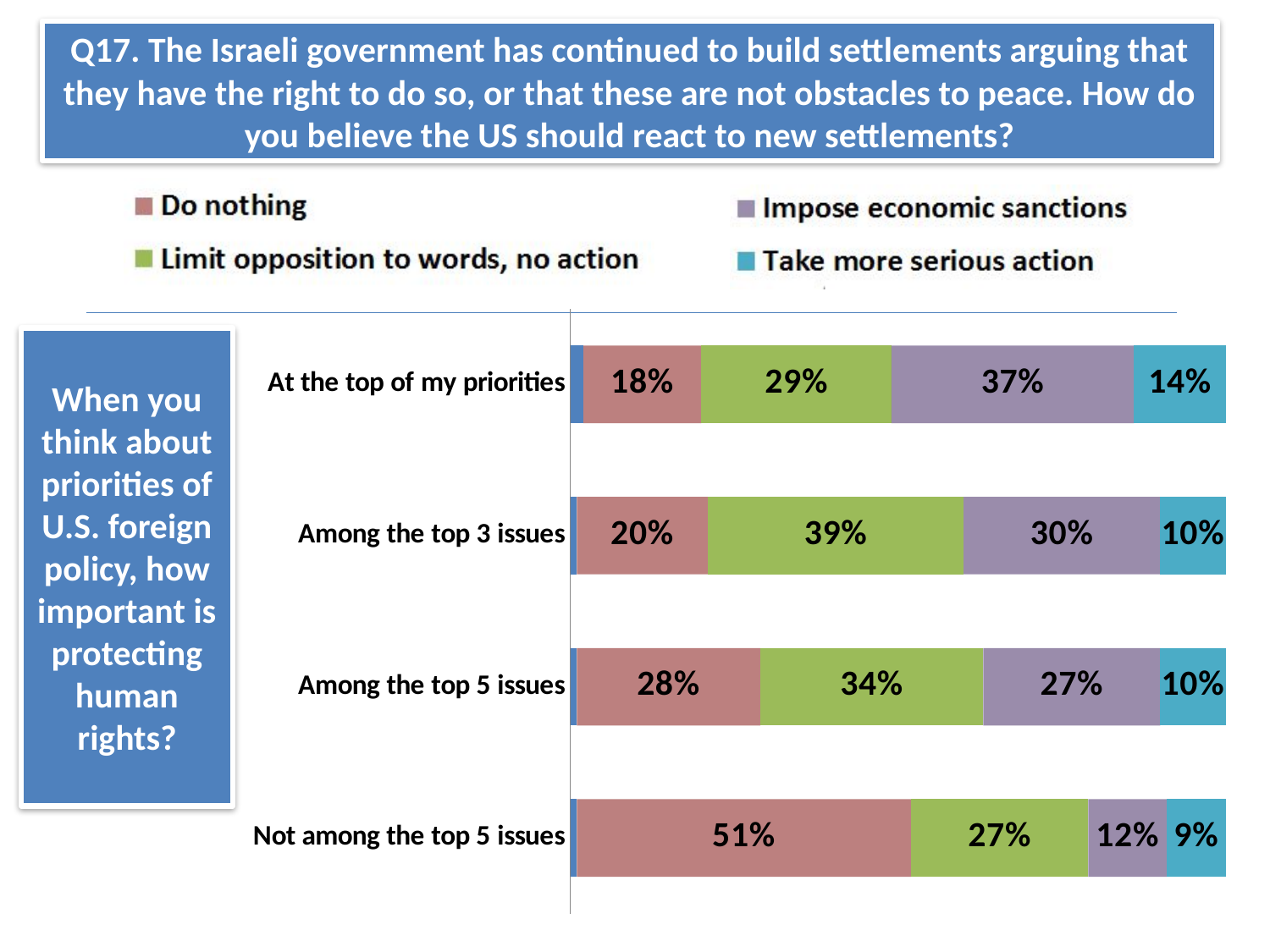
Going from 'At the top of my priorities' down to 'Not among the top 5 issues', does the 'Do nothing' percentage rise or fall? Rise What type of chart is shown on the slide? Stacked bar chart What percentage of the 'Among the top 3 issues' group chose 'Limit opposition to words, no action'? 39% How many respondent groups (bars) are shown in the chart? 4 What percentage of respondents who say human rights are 'At the top of my priorities' chose 'Impose economic sanctions'? 37% How many response options does the legend list? 4 Which is larger for the 'At the top of my priorities' group: 'Impose economic sanctions' or 'Limit opposition to words, no action'? Impose economic sanctions What is the difference between the 'Do nothing' values for 'Not among the top 5 issues' and 'At the top of my priorities'? 33% What is the 'Take more serious action' value for the 'Among the top 5 issues' group? 10% What is the 'Do nothing' value for the 'Not among the top 5 issues' group? 51% Which group has the highest 'Do nothing' percentage? Not among the top 5 issues Which group has the lowest 'Impose economic sanctions' percentage? Not among the top 5 issues